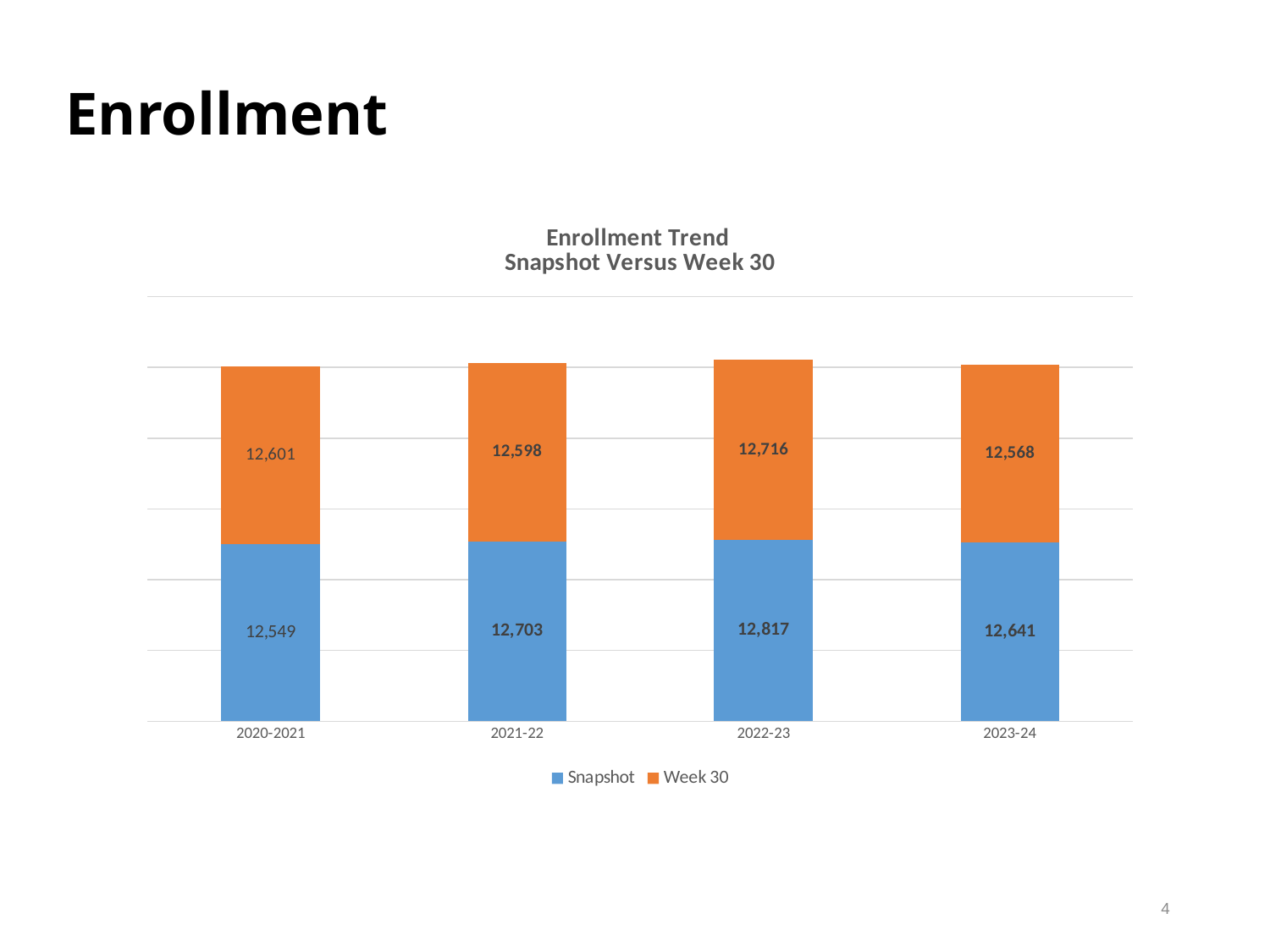
What kind of chart is shown on the slide? Stacked bar chart Which year has the lowest Snapshot enrollment? 2020-2021 What is the Week 30 value for 2023-24? 12,568 For 2021-22, which is larger: the Snapshot value or the Week 30 value? Snapshot How many school years are shown on the x axis? 4 Which year has the lowest Week 30 enrollment? 2023-24 What is the Snapshot enrollment value for 2022-23? 12,817 What is the difference between the Snapshot and Week 30 values for 2022-23? 101 How many series does the legend list? 2 What is the Week 30 enrollment value for 2020-2021? 12,601 What is the total of the stacked bar for 2020-2021? 25,150 Which year has the highest Snapshot enrollment? 2022-23